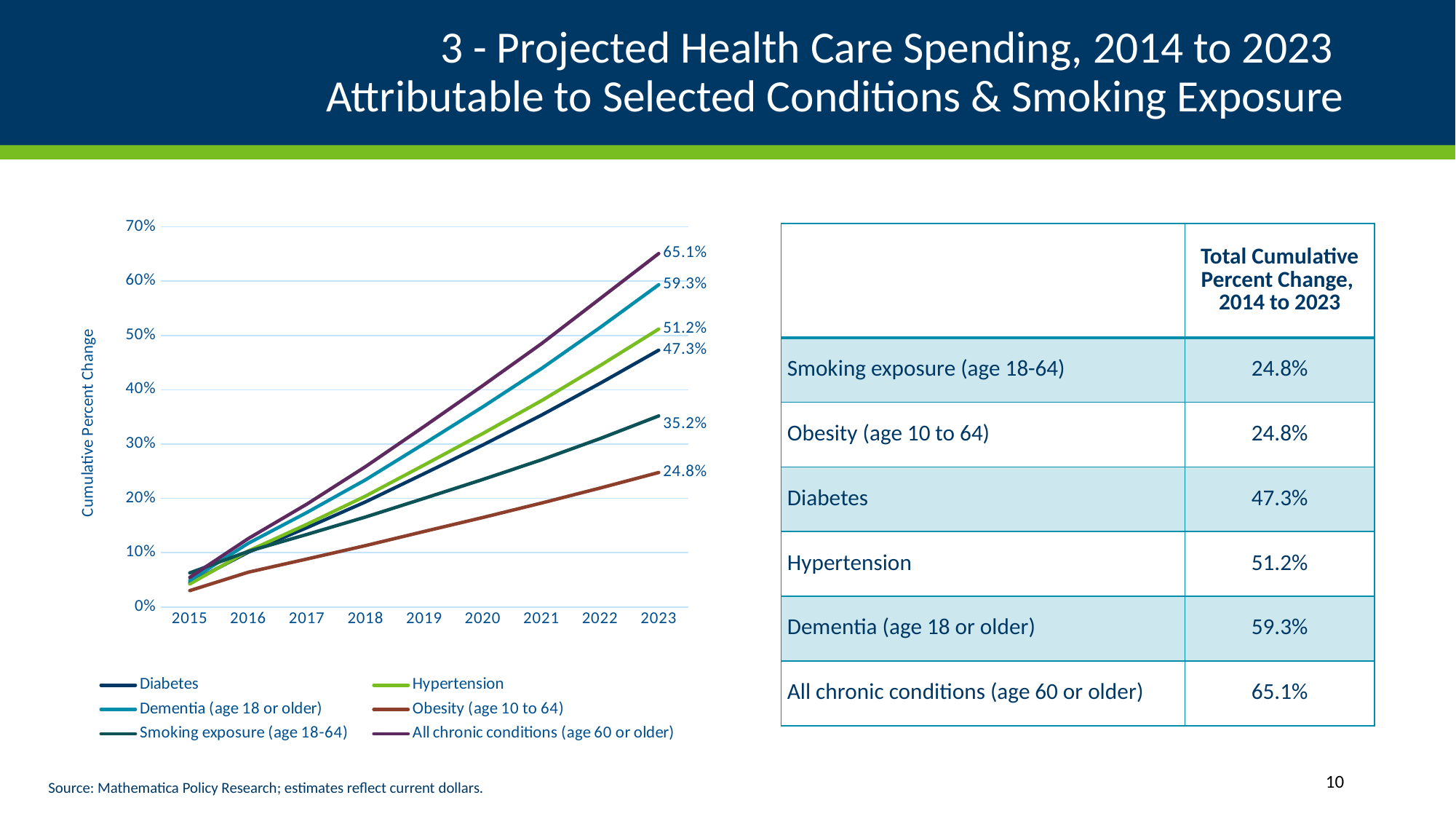
Which has the larger 2023 value, Hypertension or Diabetes? Hypertension What is the 2023 value for Obesity (age 10 to 64) in the chart? 24.8% How many years are shown along the x axis of the chart? 9 What is the 2023 value for Hypertension in the chart? 51.2% What is the 2023 value for Dementia (age 18 or older) in the chart? 59.3% Do the values in the chart rise or fall from 2015 to 2023? rise What is the difference between the 2023 values for All chronic conditions (age 60 or older) and Dementia (age 18 or older)? 5.8 percentage points How many series does the chart's legend list? 6 What type of chart is shown on the slide? line chart Which series has the lowest value in 2023? Obesity (age 10 to 64) What is the 2023 value for All chronic conditions (age 60 or older) in the chart? 65.1% Which series has the highest value in 2023? All chronic conditions (age 60 or older)